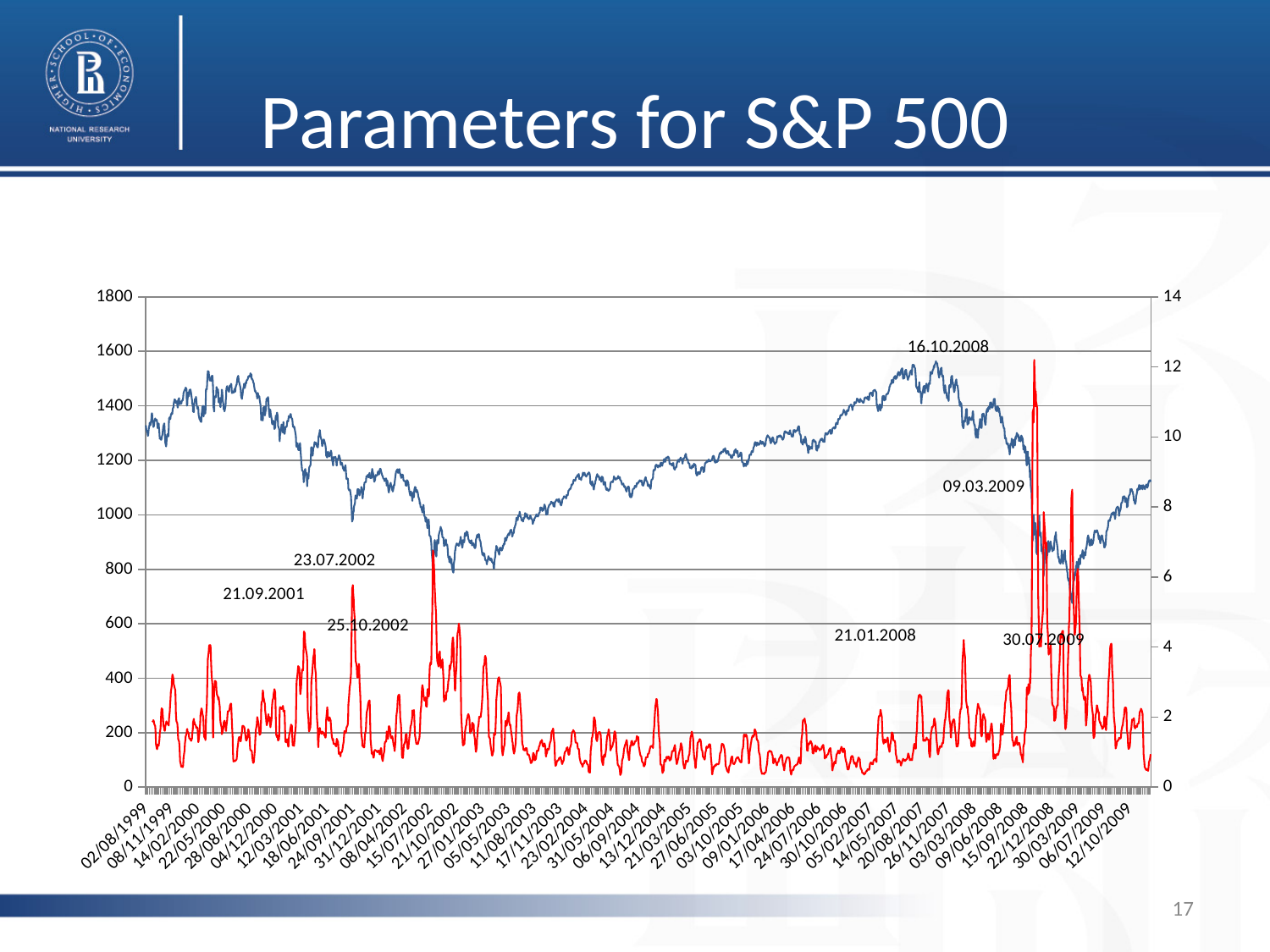
What is the highest value shown on the left vertical axis? 1800 Is the highest spike of the red line, in late 2008, greater or less than 10 on the right axis? greater Does the blue line rise or fall between 02/08/1999 and 27/01/2003? fall Which date is annotated near the top of the chart above the blue line's 2008 decline? 16.10.2008 Does the blue line rise or fall between 05/05/2003 and 20/08/2007? rise What kind of chart is shown on the slide? line chart Is the value of the blue line at the first date, 02/08/1999, greater or less than 1200 on the left axis? greater How many lines are plotted on the chart? 2 Is the lowest point of the blue line, reached around early 2003, greater or less than 1000 on the left axis? less What is the title of the slide containing the chart? Parameters for S&P 500